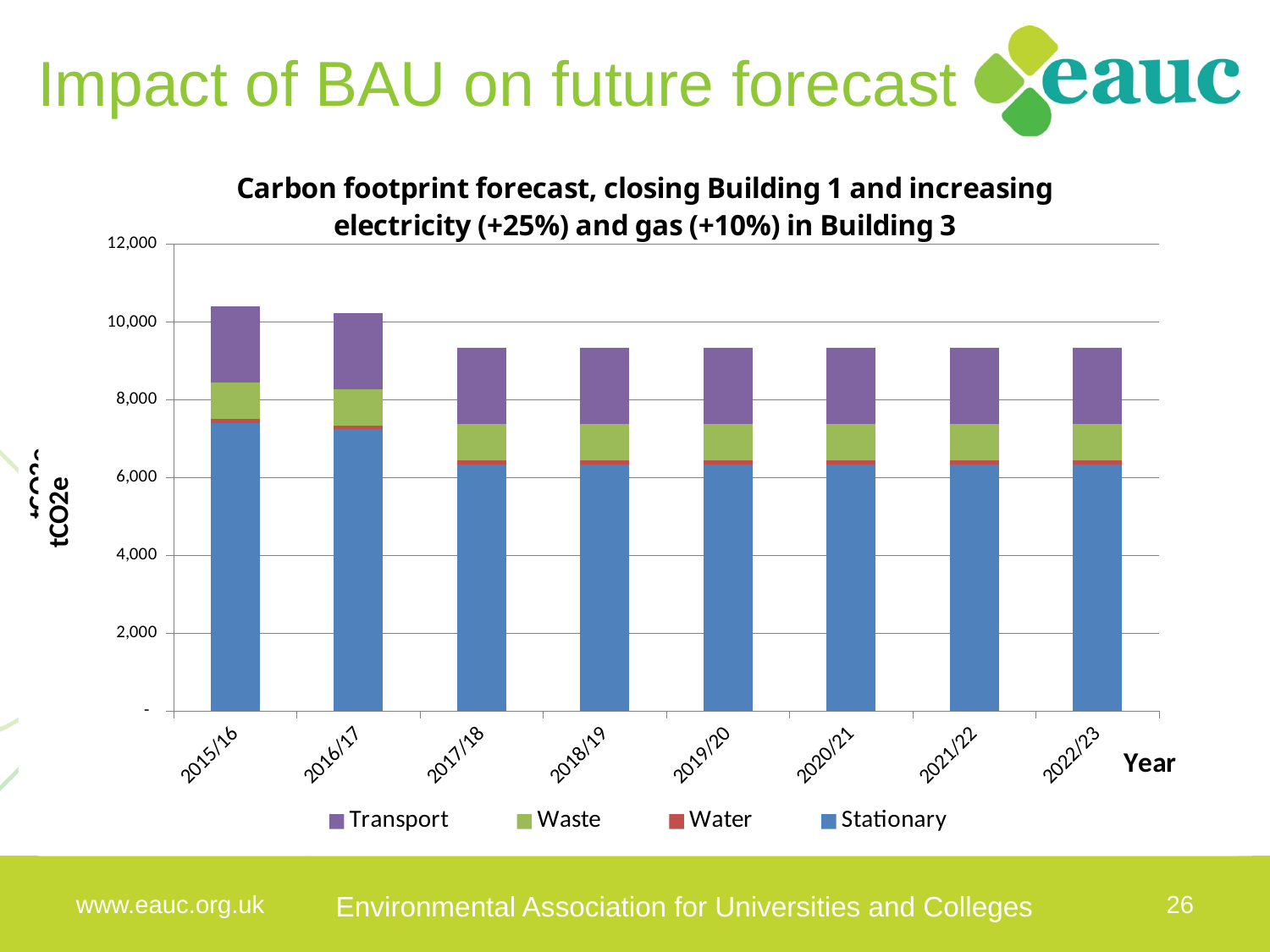
Which series is shown in purple in the chart's legend? Transport Is the Stationary value for 2015/16 greater or less than 6,000? greater What is the label on the y axis of the chart? tCO2e How many series does the chart's legend list? 4 How many years are shown on the x axis of the chart? 8 Is the total bar for 2017/18 greater or less than 10,000? less Which total is larger, 2016/17 or 2019/20? 2016/17 What kind of chart is shown on the slide? Stacked bar chart Do the total values rise or fall from 2015/16 to 2017/18? fall Is the total bar for 2015/16 greater or less than 10,000? greater Which year has the highest total carbon footprint in the chart? 2015/16